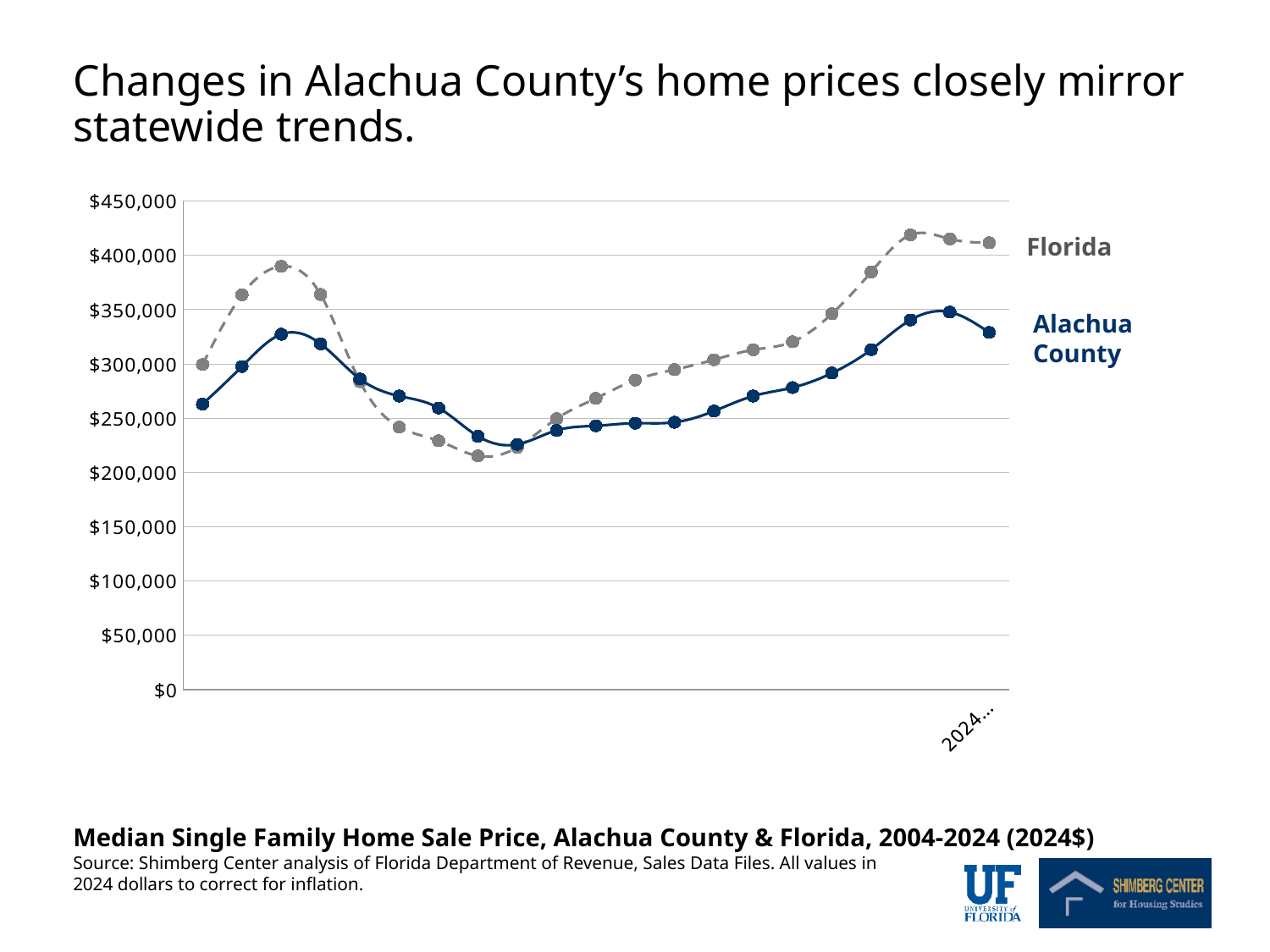
Is the highest value of the Florida line greater or less than $400,000? greater Is the first (leftmost) value of the Alachua County line greater or less than $300,000? less Is the lowest value of the Alachua County line greater or less than $250,000? less Which series is drawn with a gray dashed line? Florida How many data points does the Alachua County line have? 21 How many series does the chart show? 2 Overall, from the first point to the last point, do the Alachua County values rise or fall? rise What kind of chart is shown on the slide? line chart Which series reaches the highest value on the chart, Florida or Alachua County? Florida At the last point on the chart, which series has the higher value, Florida or Alachua County? Florida